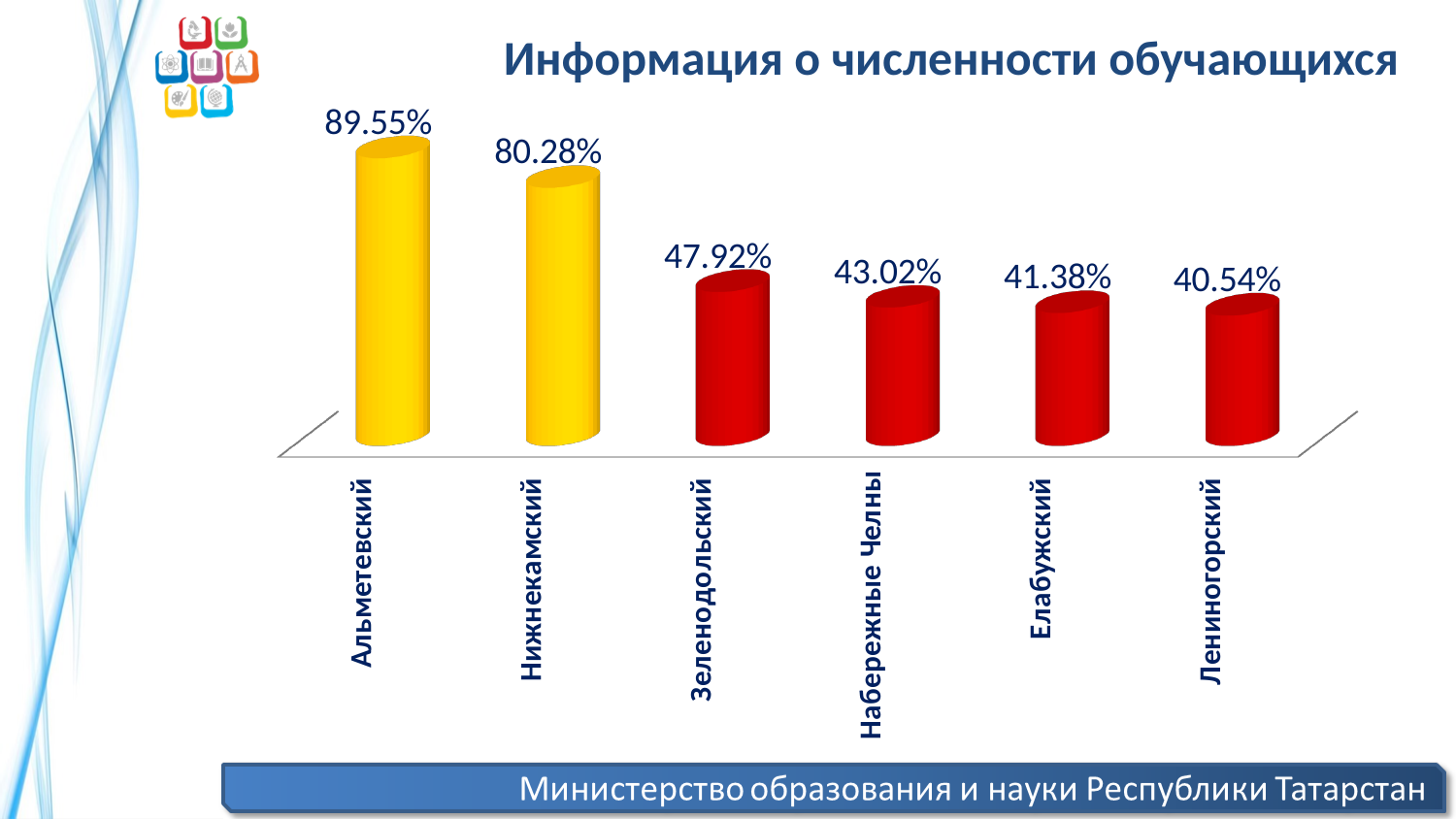
How many categories are shown in the chart? 6 Do the values rise or fall from left to right along the x axis? Fall What is the value for Лениногорский? 40.54% What is the title of the slide? Информация о численности обучающихся What kind of chart is shown on the slide? Bar chart What is the difference between the values for Зеленодольский and Елабужский? 6.54% What is the value for Альметевский? 89.55% Which is larger, the value for Нижнекамский or the value for Зеленодольский? Нижнекамский What is the value for Набережные Челны? 43.02% Which category has the lowest value? Лениногорский Which category has the highest value? Альметевский What is the difference between the values for Альметевский and Нижнекамский? 9.27%